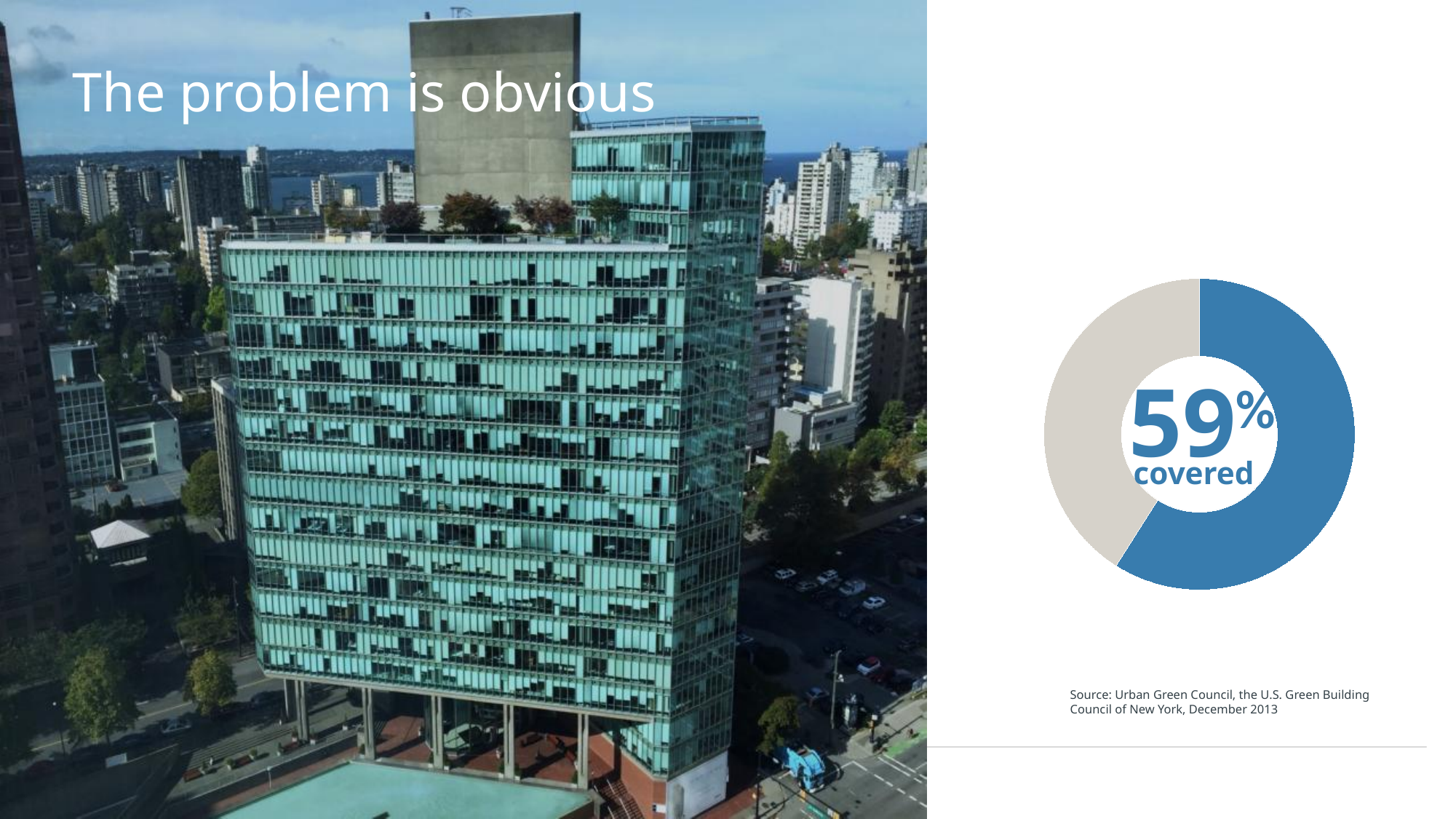
What is the title of the slide containing the donut chart? The problem is obvious What percentage is labelled as "covered" in the donut chart? 59% What share of the donut chart is not covered? 41% Which slice of the donut chart is larger, the blue one or the grey one? the blue one Is the "covered" share in the donut chart greater or less than 50%? greater What colour is the "covered" slice of the donut chart? blue How many slices does the donut chart have? 2 What kind of chart is shown on the right side of the slide? donut (pie) chart